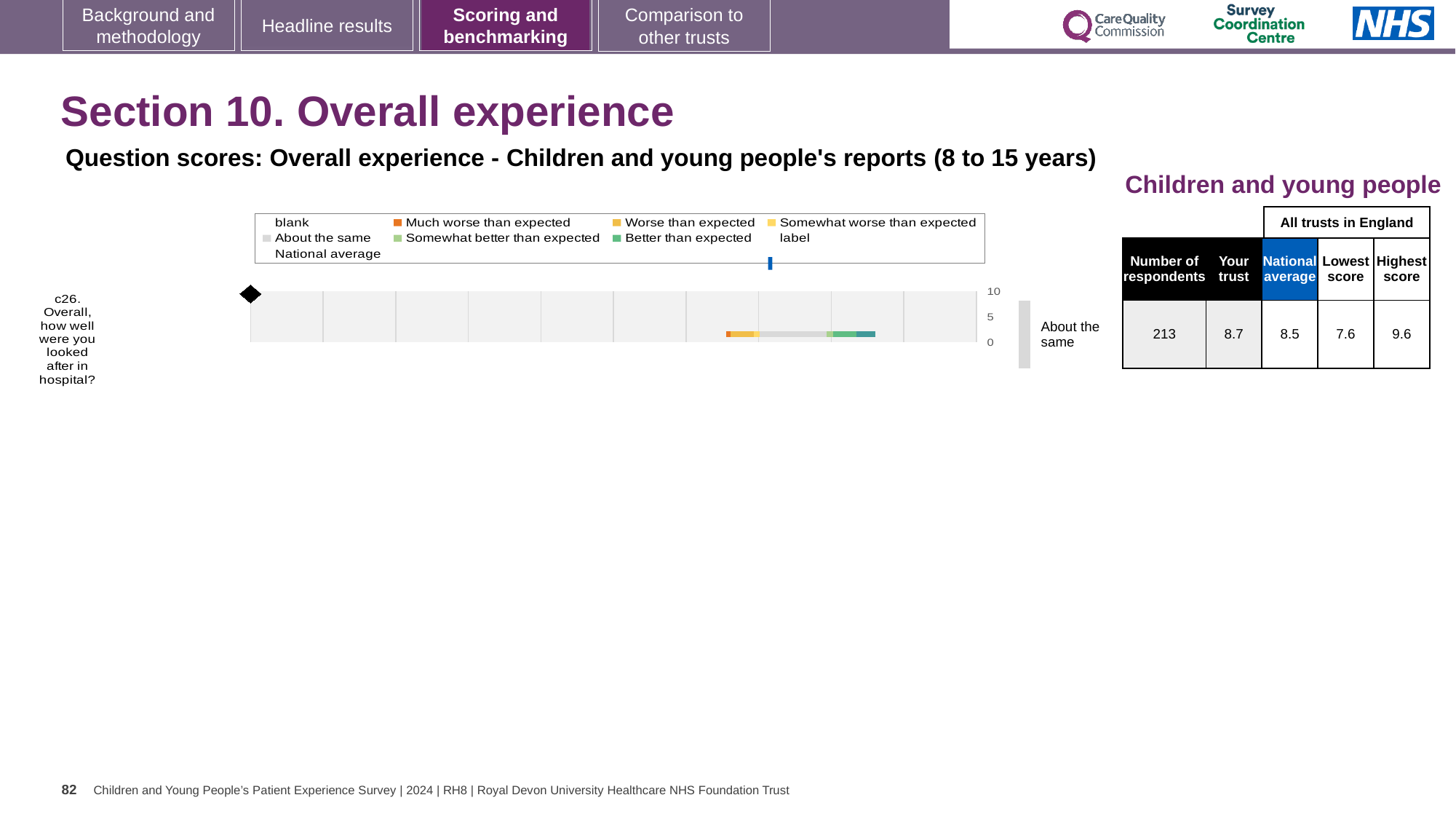
What is the difference between the 'Your trust' score and the national average for question c26? 0.2 How many respondents answered question c26? 213 How many questions are plotted on the chart? 1 What is the highest score among all trusts in England for question c26? 9.6 What is the 'Your trust' score for question c26 'Overall, how well were you looked after in hospital?' 8.7 What is the maximum value shown on the chart's score axis? 10 What kind of chart is used to show the question score for c26? Bar chart How is the trust's result for question c26 categorised relative to other trusts? About the same What is the difference between the highest score and the lowest score for question c26? 2.0 What is the national average score shown for question c26? 8.5 Which is larger for question c26: the 'Your trust' score or the national average? Your trust What is the lowest score among all trusts in England for question c26? 7.6